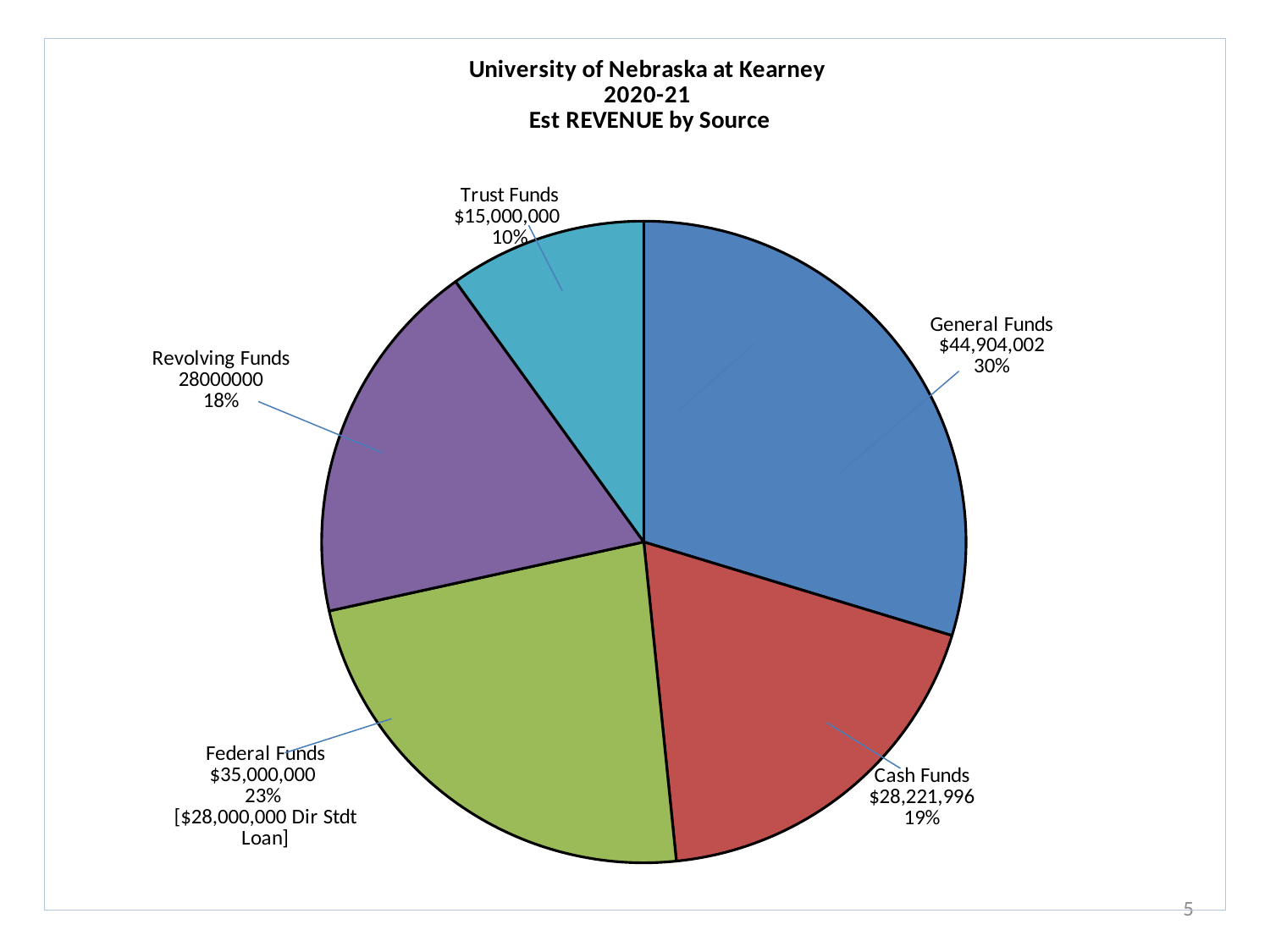
What is the estimated revenue from General Funds? $44,904,002 Which is larger, Federal Funds or Revolving Funds? Federal Funds How many revenue sources are shown in the pie chart? 5 What percentage share of the pie do Federal Funds represent? 23% Which revenue source has the smallest share of the pie? Trust Funds What type of chart is shown on the slide? Pie chart What is the estimated revenue from Federal Funds? $35,000,000 What is the estimated revenue from Cash Funds? $28,221,996 Which revenue source has the largest share of the pie? General Funds What percentage share of the pie do Revolving Funds represent? 18% What is the estimated revenue from Trust Funds? $15,000,000 What is the difference between General Funds and Cash Funds revenue? $16,682,006